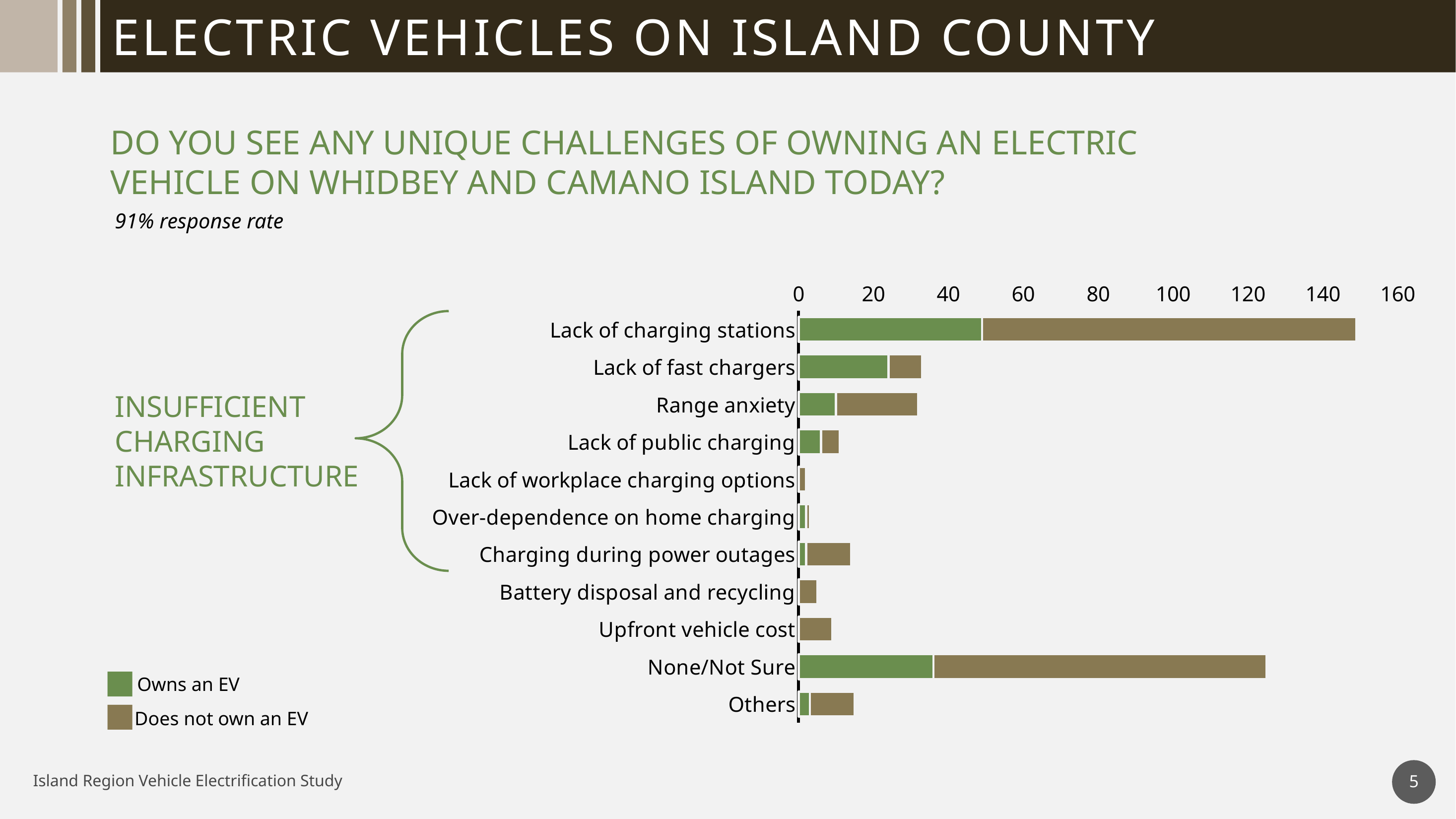
Is the total bar for Lack of public charging greater or less than 20? less What kind of chart is shown on the slide? bar chart How many categories (challenges) are plotted in the chart? 11 Which series is shown in green in the chart? Owns an EV What are the two legend entries of the chart? Owns an EV; Does not own an EV Is the total bar for None/Not Sure greater or less than 100? greater Is the total bar for Lack of charging stations greater or less than 140? greater Which has the longer total bar, Upfront vehicle cost or Battery disposal and recycling? Upfront vehicle cost How many series does the chart's legend list? 2 Which has the longer total bar, Lack of charging stations or None/Not Sure? Lack of charging stations Which challenge has the longest total bar? Lack of charging stations